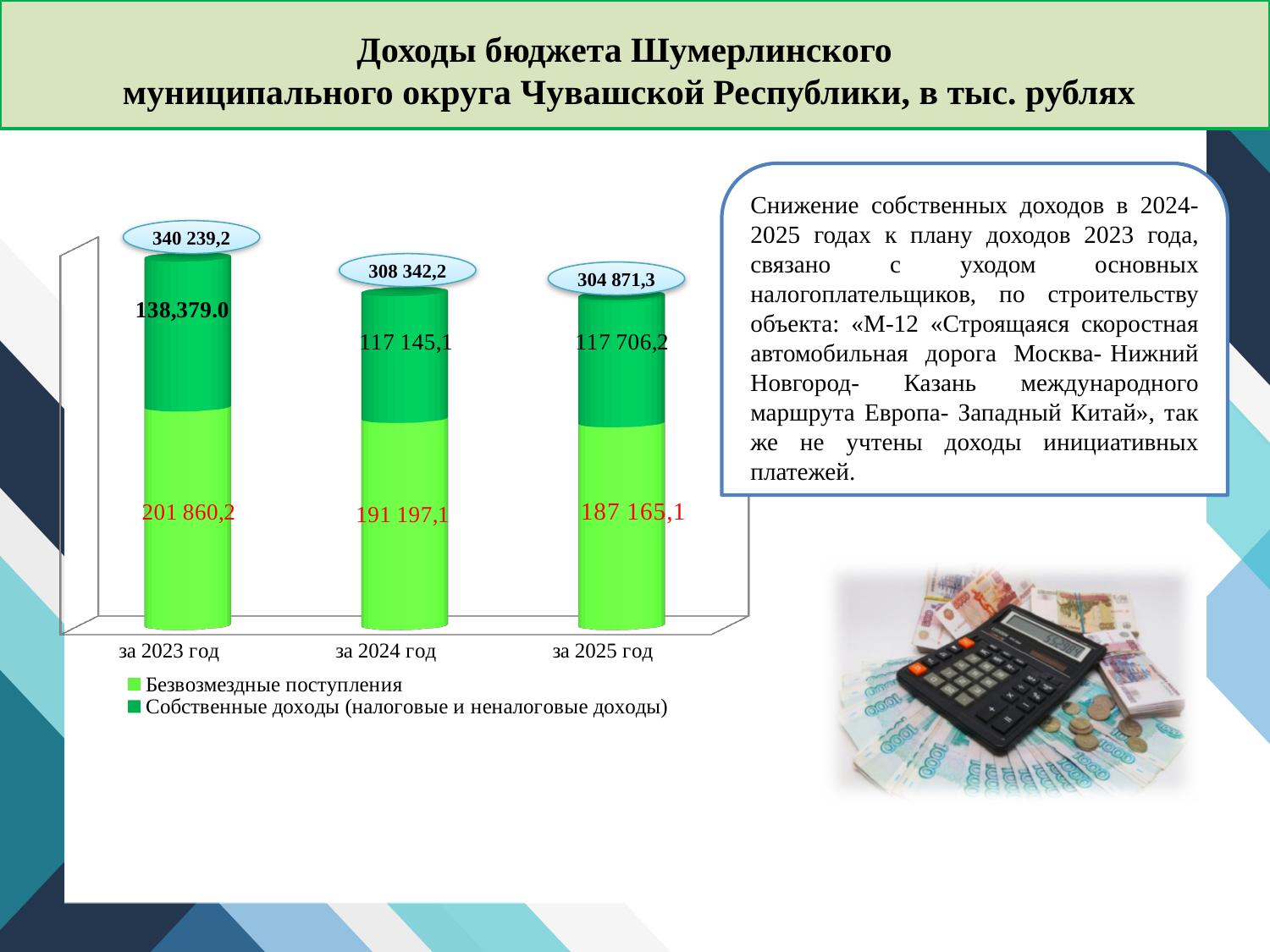
How many categories (years) are shown on the x axis? 3 What is the difference between the totals for за 2023 год and за 2025 год? 35 367,9 Which year has the highest total budget income? за 2023 год Which is larger: Безвозмездные поступления for за 2023 год or for за 2025 год? за 2023 год What is the value of Собственные доходы (налоговые и неналоговые доходы) for за 2025 год? 117 706,2 What is the total shown above the bar for за 2024 год? 308 342,2 How many series does the legend list? 2 Do the total values rise or fall from за 2023 год to за 2025 год? Fall What is the value of Собственные доходы (налоговые и неналоговые доходы) for за 2023 год? 138,379.0 What type of chart is shown on the slide? Stacked bar chart What is the value of Безвозмездные поступления for за 2024 год? 191 197,1 Which year has the lowest value for Безвозмездные поступления? за 2025 год